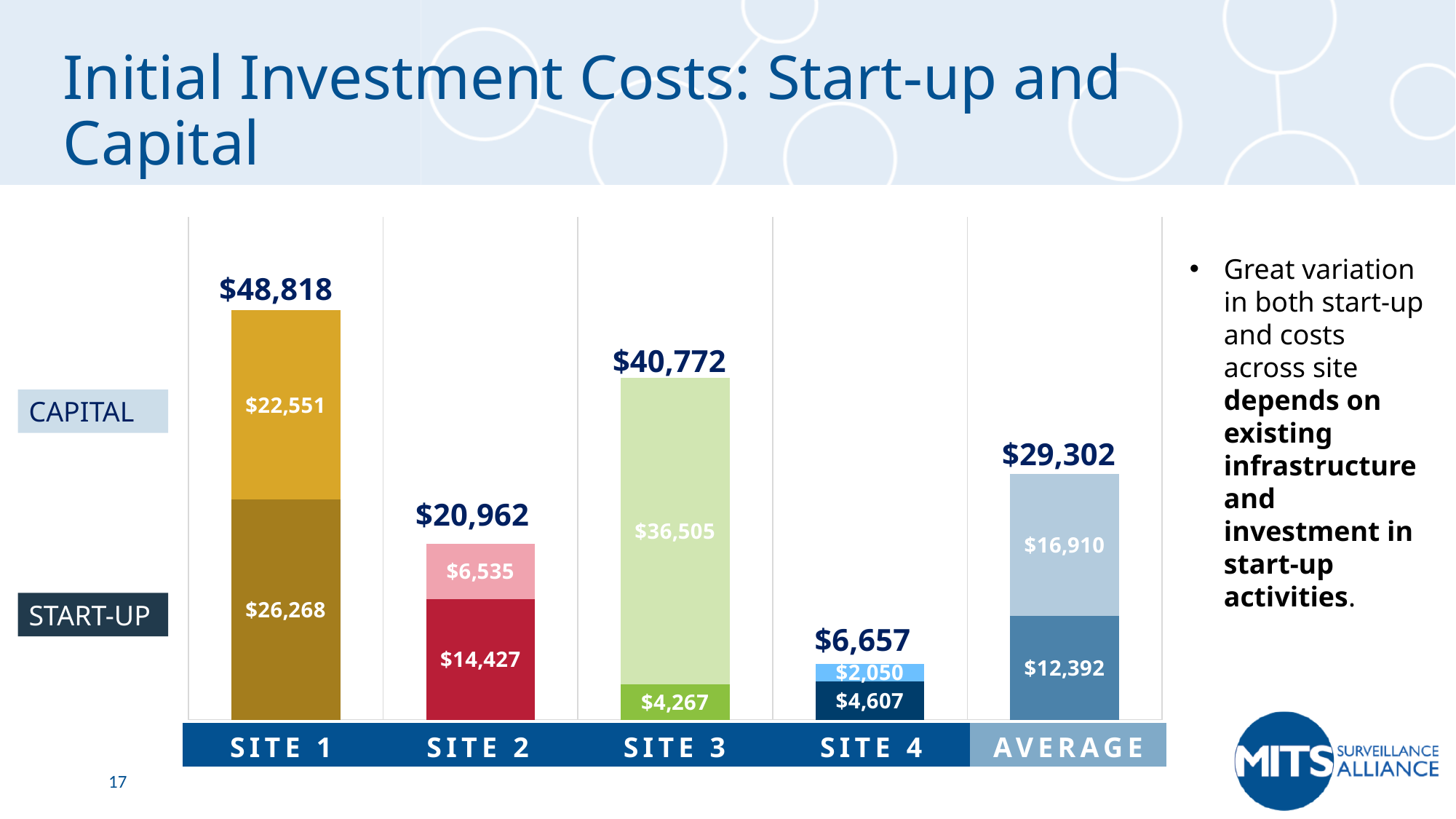
What is the start-up cost for Site 2? $14,427 Which site has the lowest total initial investment cost? Site 4 What is the total initial investment cost for Site 1? $48,818 How many bars are shown in the chart? 5 What kind of chart is shown on the slide? Stacked bar chart How many series does the chart's legend list? 2 What is the start-up cost shown for the Average bar? $12,392 What is the capital cost for Site 4? $2,050 Which site has the highest total initial investment cost? Site 1 What is the difference between the total costs of Site 1 and Site 3? $8,046 Which is larger, the start-up cost for Site 1 or the capital cost for Site 1? Start-up cost ($26,268) What is the capital cost for Site 3? $36,505